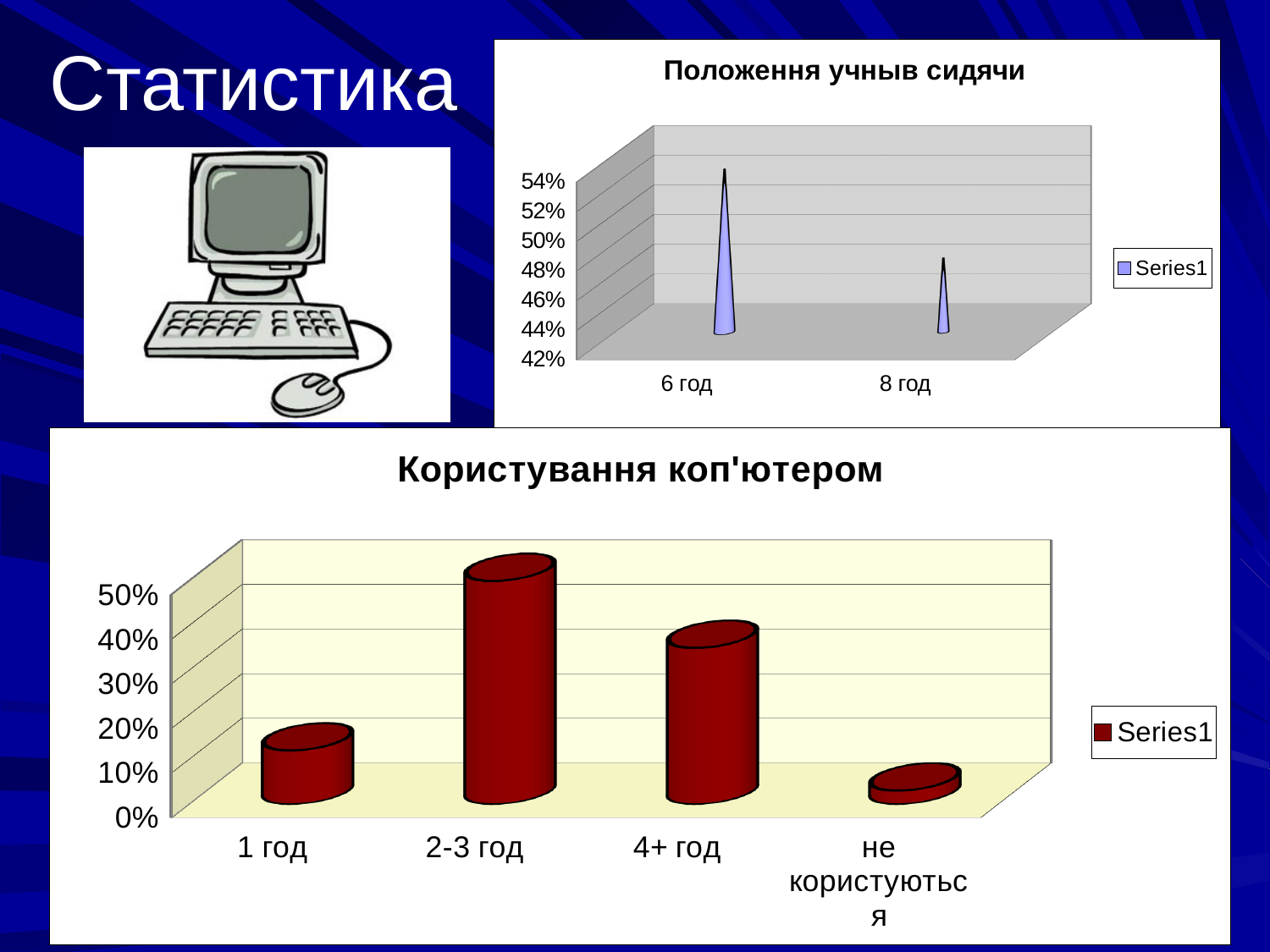
In the chart titled "Користування коп'ютером", which category has the lowest value? не користуються In the chart titled "Положення учнів сидячи" (top right), which category has the higher value? 6 год In the chart titled "Користування коп'ютером", is the value for "4+ год" greater or less than 30%? greater In the chart titled "Положення учнів сидячи" (top right), is the value for "8 год" greater or less than 50%? less In the chart titled "Користування коп'ютером", which is larger: the value for "1 год" or the value for "4+ год"? 4+ год In the chart titled "Користування коп'ютером", how many categories are shown on the x axis? 4 What kind of chart is the one titled "Користування коп'ютером"? bar chart In the chart titled "Користування коп'ютером", which category has the highest value? 2-3 год In the chart titled "Положення учнів сидячи" (top right), how many categories are shown on the x axis? 2 How many series does the legend of the chart titled "Користування коп'ютером" list? 1 In the chart titled "Користування коп'ютером", is the value for "1 год" greater or less than 30%? less